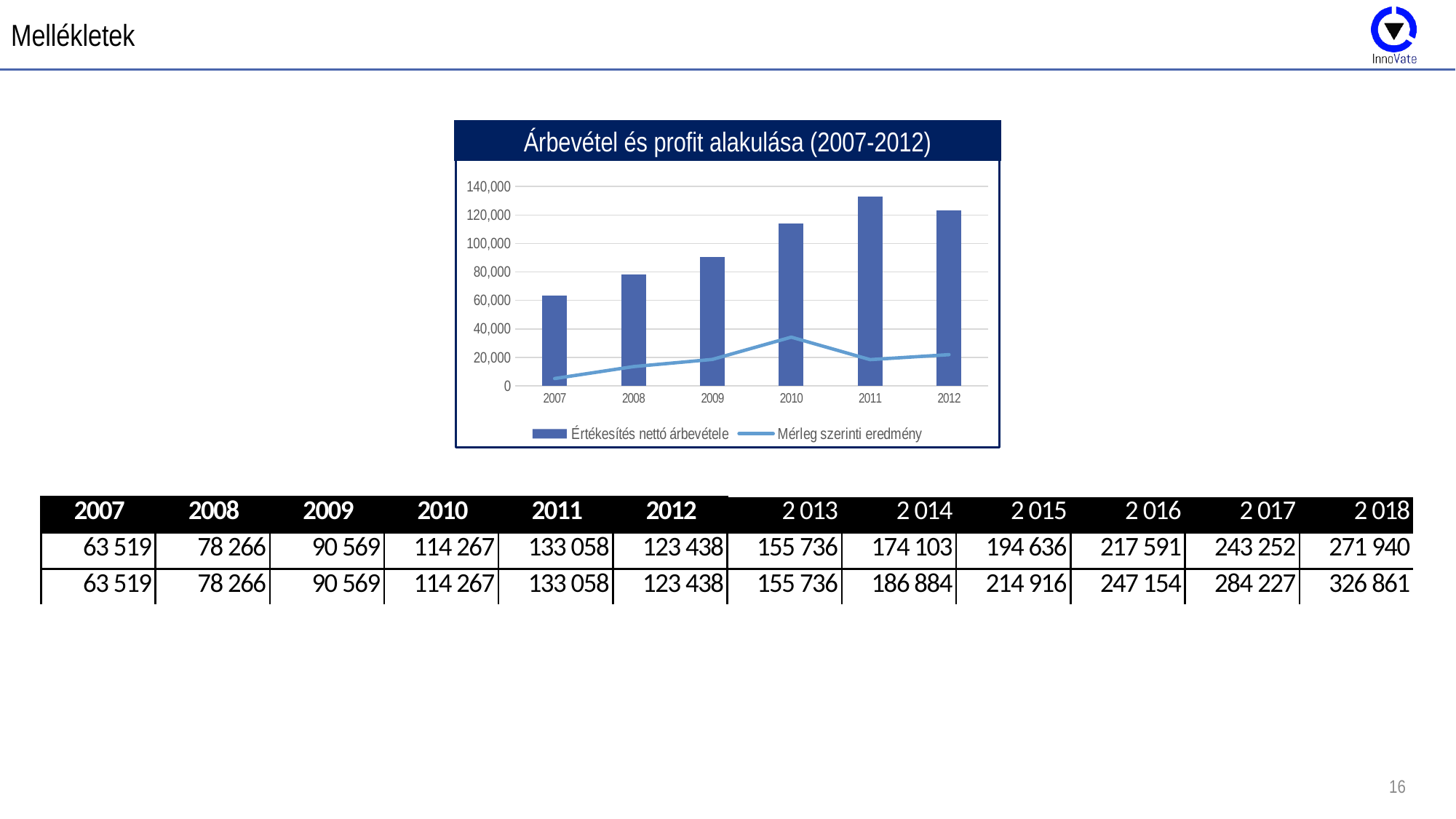
Which year has the highest bar for Értékesítés nettó árbevétele? 2011 Is the bar for Értékesítés nettó árbevétele in 2010 greater or less than 100,000? greater Is the Mérleg szerinti eredmény value for 2007 greater or less than 20,000? less What kind of chart is shown on the slide? Combined bar and line chart Which year has the lowest bar for Értékesítés nettó árbevétele? 2007 Is the bar for Értékesítés nettó árbevétele in 2008 greater or less than 80,000? less Which series is drawn as a line in the chart? Mérleg szerinti eredmény How many series does the chart legend list? 2 Which year has the larger bar for Értékesítés nettó árbevétele, 2010 or 2012? 2012 What is the title of the chart? Árbevétel és profit alakulása (2007-2012) How many years are shown on the x axis of the chart? 6